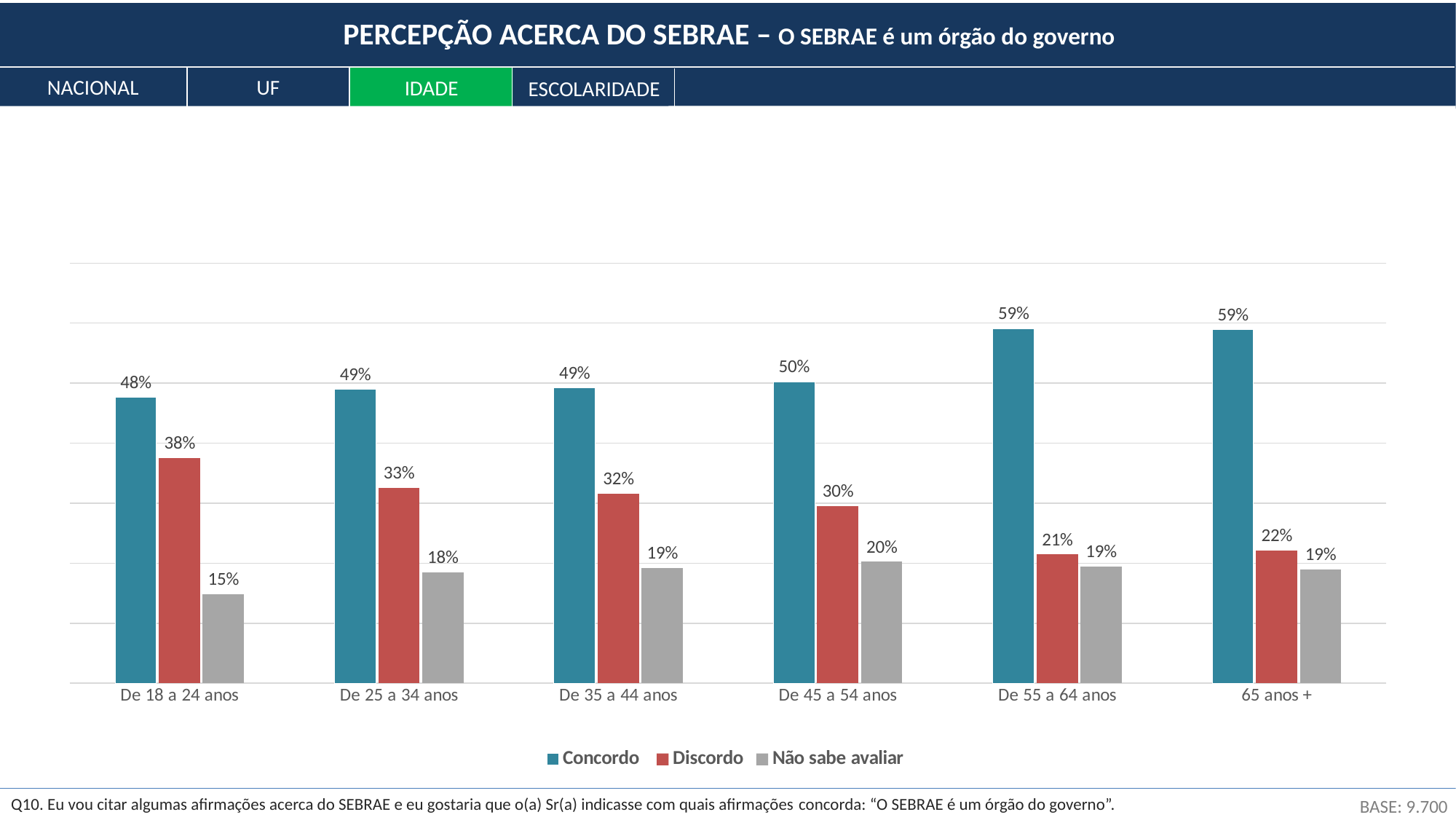
What is the Concordo value for De 18 a 24 anos? 48% Which is larger, the Discordo value for De 35 a 44 anos or the Discordo value for De 55 a 64 anos? De 35 a 44 anos Which tab is highlighted in green on the slide? IDADE What is the difference between the Concordo and Discordo values for 65 anos +? 37% Does the Discordo value generally rise or fall from De 18 a 24 anos to De 45 a 54 anos? Fall Which age group has the lowest Não sabe avaliar value? De 18 a 24 anos What is the Não sabe avaliar value for De 25 a 34 anos? 18% How many age groups are shown on the x axis? 6 How many series does the legend list? 3 Which age group has the highest Discordo value? De 18 a 24 anos What is the Discordo value for De 45 a 54 anos? 30% What kind of chart is shown on the slide? Bar chart